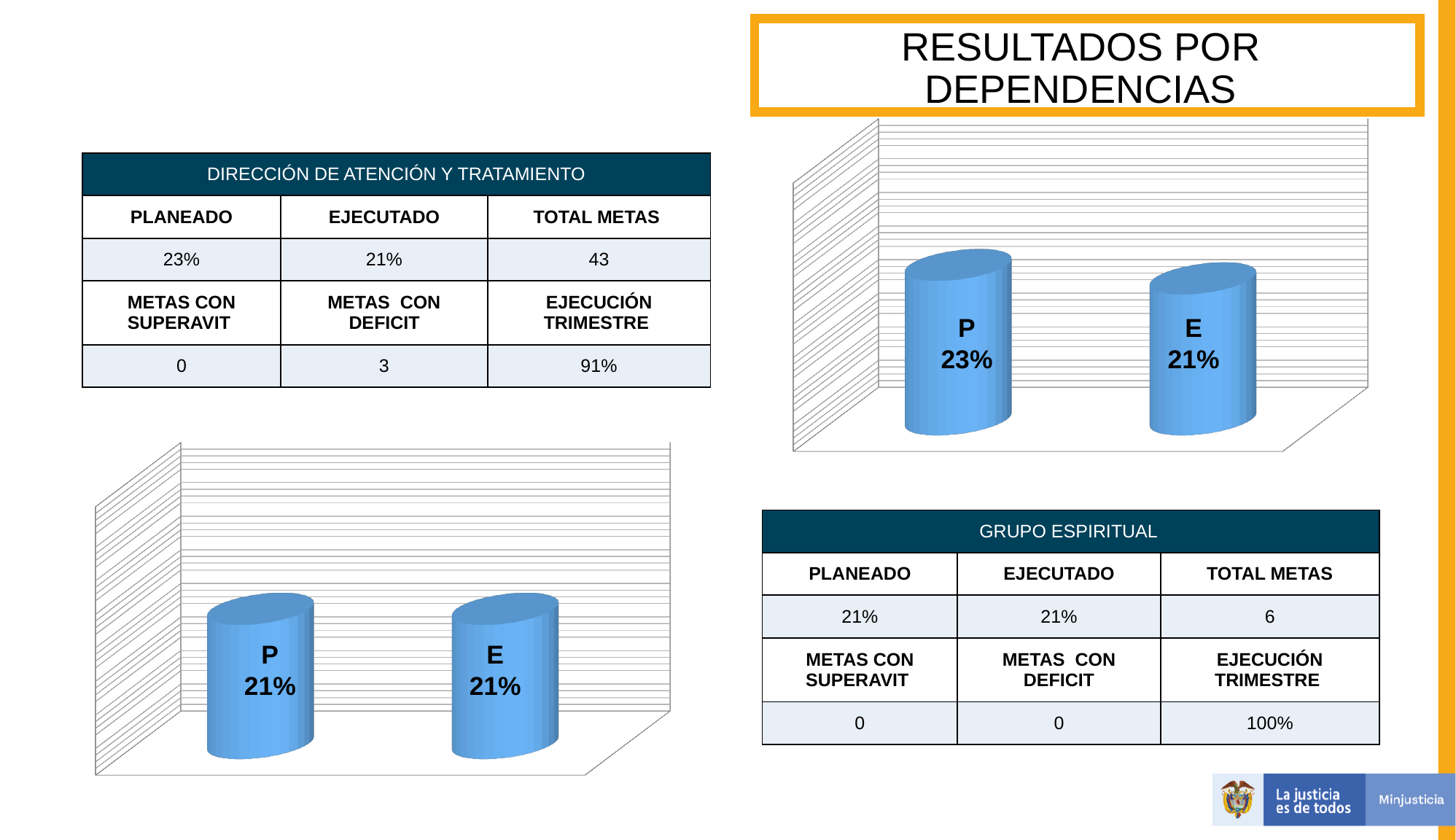
In the chart at the top right of the slide, what is the value for P? 23% In the chart at the top right of the slide, which is larger, the value for P or the value for E? P How many categories are plotted in the chart at the bottom left of the slide? 2 In the chart at the top right of the slide, what is the value for E? 21% In the chart at the bottom left of the slide, what is the value for P? 21% In the chart at the top right of the slide, which category has the highest value? P What kind of chart is shown at the top right of the slide? Bar chart In the chart at the top right of the slide, which category has the lowest value? E In the chart at the bottom left of the slide, what is the difference between the values for P and E? 0% In the chart at the bottom left of the slide, what is the value for E? 21% What colour are the bars in the chart at the bottom left of the slide? Blue In the chart at the top right of the slide, what is the difference between the values for P and E? 2%